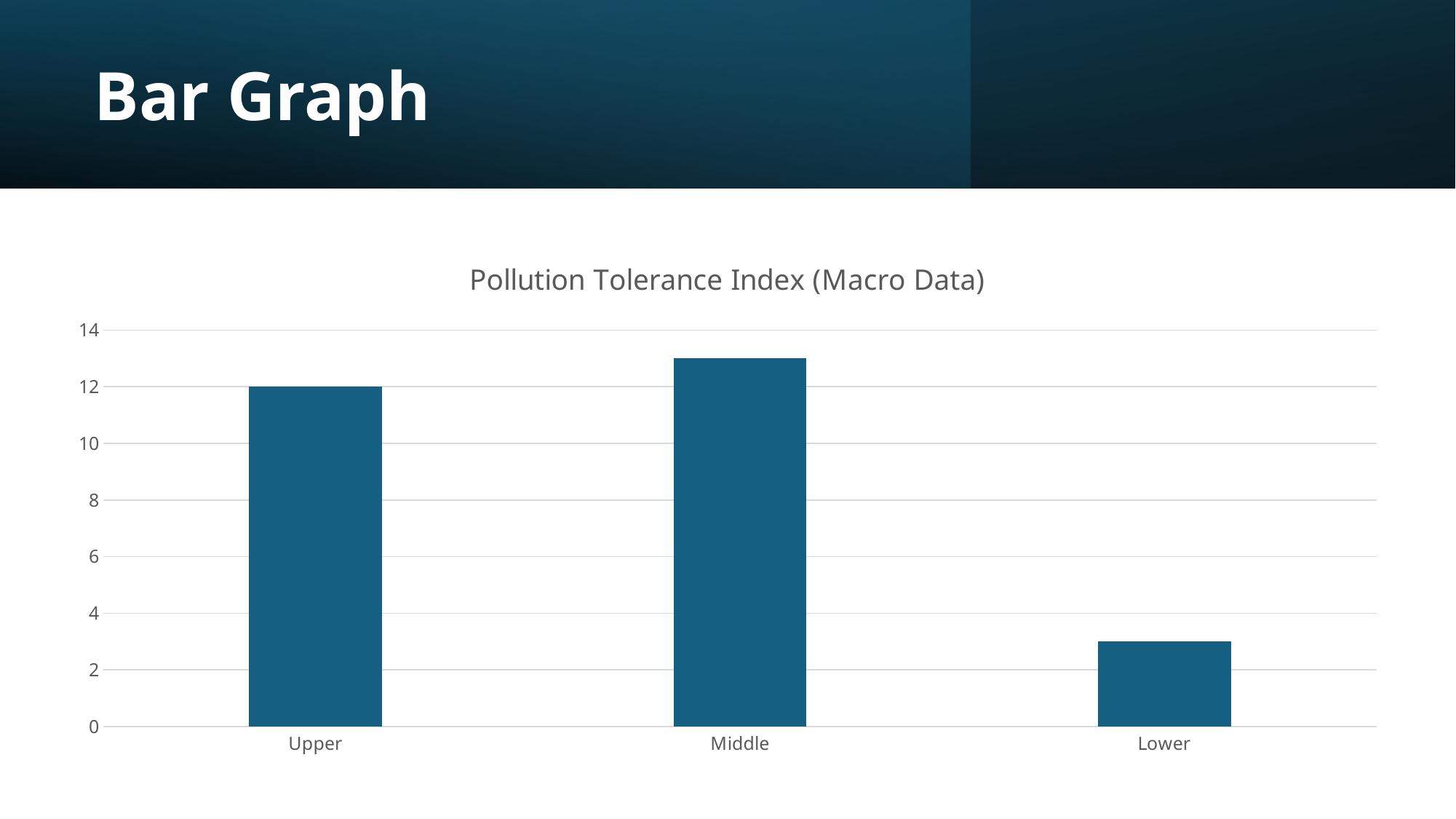
Which is larger, the value for Middle or the value for Upper? Middle What kind of chart is shown on the slide? Bar chart Does the value rise or fall from Middle to Lower? fall Is the value for Lower greater or less than 4? less How many categories are shown on the x axis of the chart? 3 Which is larger, the value for Upper or the value for Lower? Upper What is the value for Upper? 12 Is the value for Middle greater or less than 12? greater What is the title of the chart? Pollution Tolerance Index (Macro Data) Is the value for Lower greater or less than 2? greater Which category has the highest value? Middle Which category has the lowest value? Lower